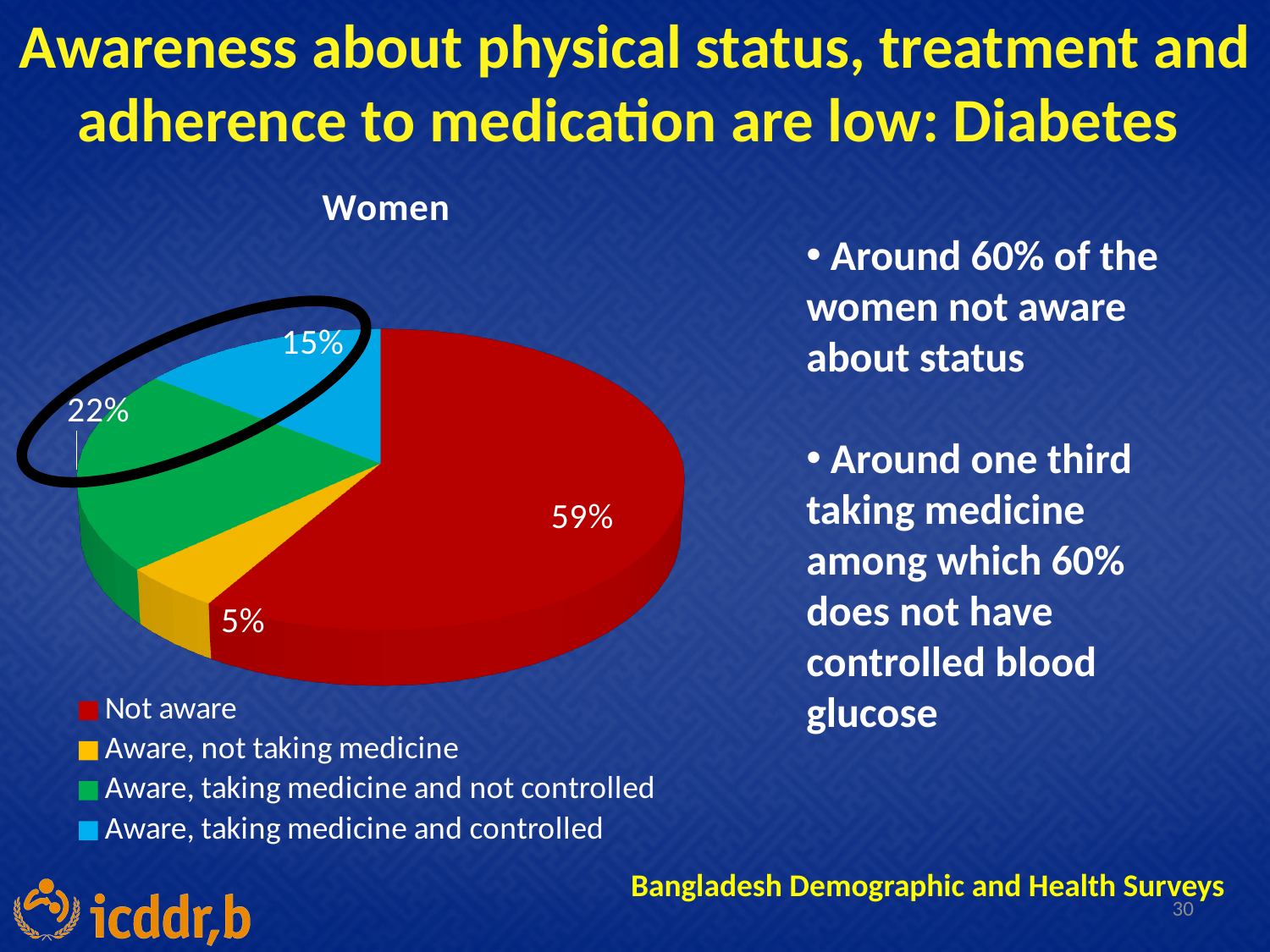
What is the difference between the 'Not aware' share and the 'Aware, taking medicine and not controlled' share? 37% What percentage of women are 'Aware, taking medicine and controlled'? 15% What percentage of women are shown as 'Not aware'? 59% Which is larger: the share for 'Aware, taking medicine and not controlled' or 'Aware, taking medicine and controlled'? Aware, taking medicine and not controlled How many categories does the pie chart show? 4 What kind of chart is shown on the slide? Pie chart Which category has the largest share of the pie? Not aware What colour represents the 'Not aware' category in the pie chart? Red What is the title of the chart? Women What percentage of women are 'Aware, taking medicine and not controlled'? 22% Which category has the smallest share of the pie? Aware, not taking medicine What percentage of women are 'Aware, not taking medicine'? 5%